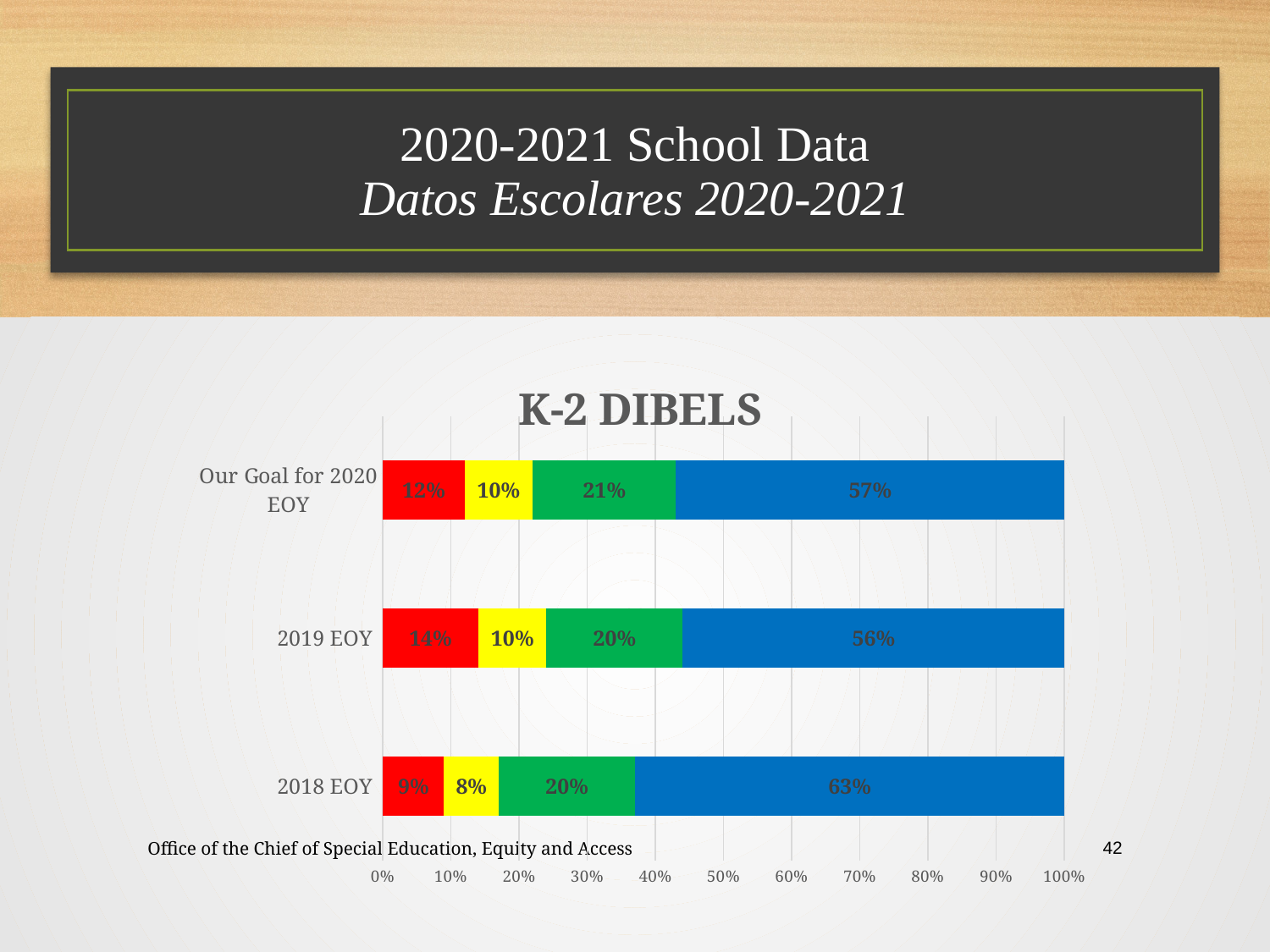
What is the value of the green segment for Our Goal for 2020 EOY? 21% Which is larger: the red segment for 2019 EOY or the red segment for Our Goal for 2020 EOY? 2019 EOY What is the difference between the blue segment for 2018 EOY and the blue segment for 2019 EOY? 7% What is the value of the blue segment for 2018 EOY? 63% How many categories are shown on the K-2 DIBELS chart? 3 What type of chart is the K-2 DIBELS chart? Stacked bar chart Which category has the largest blue segment? 2018 EOY Which category has the smallest red segment? 2018 EOY What is the value of the red segment for 2019 EOY? 14% What is the title of the chart? K-2 DIBELS What is the value of the yellow segment for 2018 EOY? 8% What is the total of the stacked bar for 2019 EOY? 100%